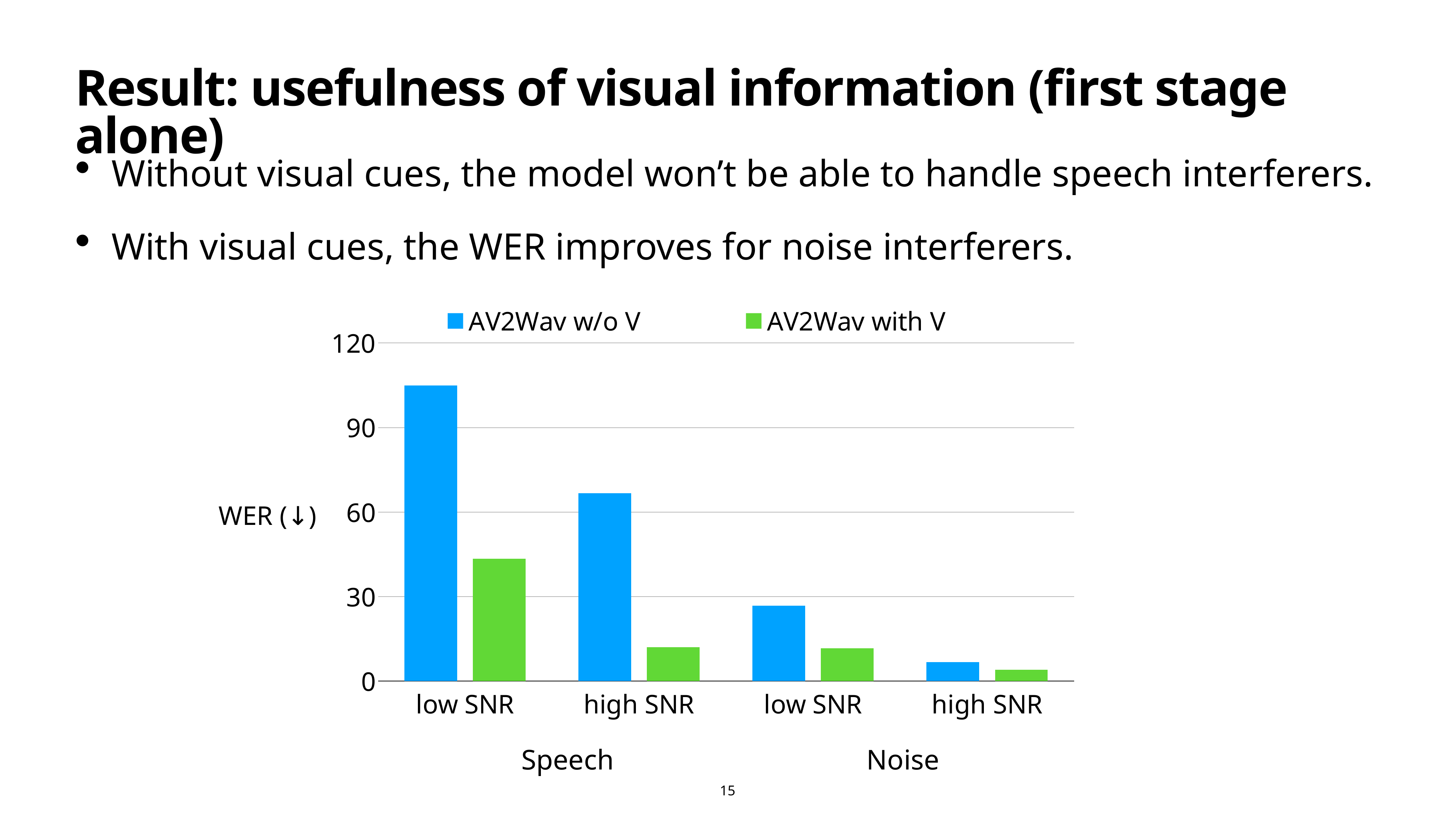
Is the AV2Wav w/o V value for Noise low SNR greater or less than 30? less Among the AV2Wav with V bars, which category has the lowest value? Noise high SNR Which bar is the highest in the chart? AV2Wav w/o V, Speech low SNR What is the label on the y axis of the chart? WER (↓) Is the AV2Wav w/o V value for Speech low SNR greater or less than 90? greater Which is larger: the AV2Wav with V value for Speech low SNR or the AV2Wav w/o V value for Noise low SNR? AV2Wav with V for Speech low SNR Among the AV2Wav w/o V bars, which category has the lowest value? Noise high SNR How many series does the legend list? 2 How many categories are shown along the x axis? 4 Is the AV2Wav with V value for Speech low SNR greater or less than 60? less What kind of chart is shown on the slide? bar chart For Speech high SNR, which series has the larger value, AV2Wav w/o V or AV2Wav with V? AV2Wav w/o V